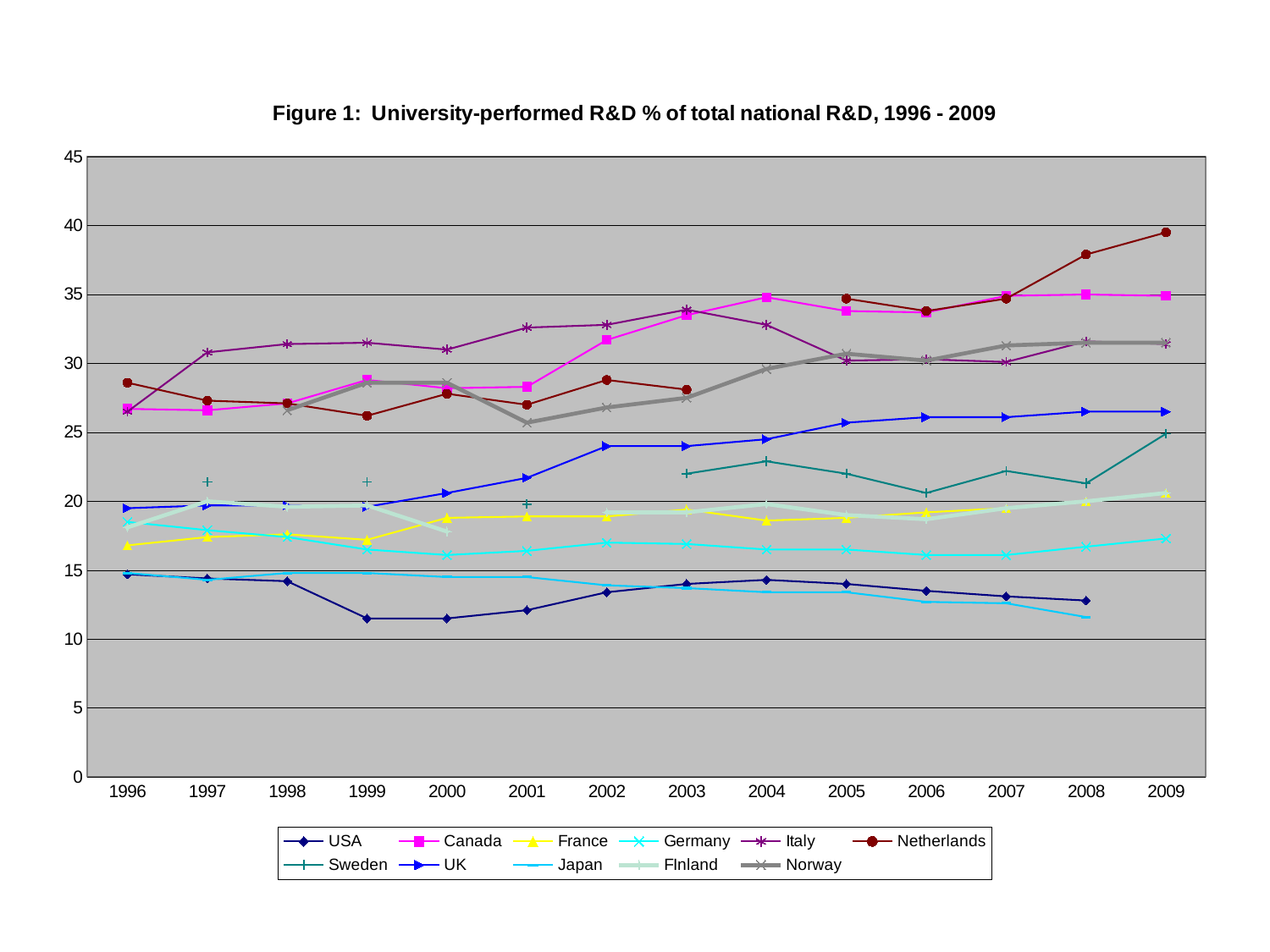
Which country has the lowest value in 1999? USA How many countries (series) does the legend list? 11 What kind of chart is shown on the slide? line chart Is the value for USA in 1999 greater or less than 15? less How many years are shown along the x axis? 14 Is the value for Netherlands in 2009 greater or less than 35? greater Does the UK line rise or fall from 1996 to 2009? rise Which country has the highest value in 2009? Netherlands In 2005, which is larger: the value for UK or the value for Germany? UK What is the title of the chart? Figure 1: University-performed R&D % of total national R&D, 1996 - 2009 Does the Japan line rise or fall from 1996 to 2008? fall Is the value for Canada in 2004 greater or less than 30? greater